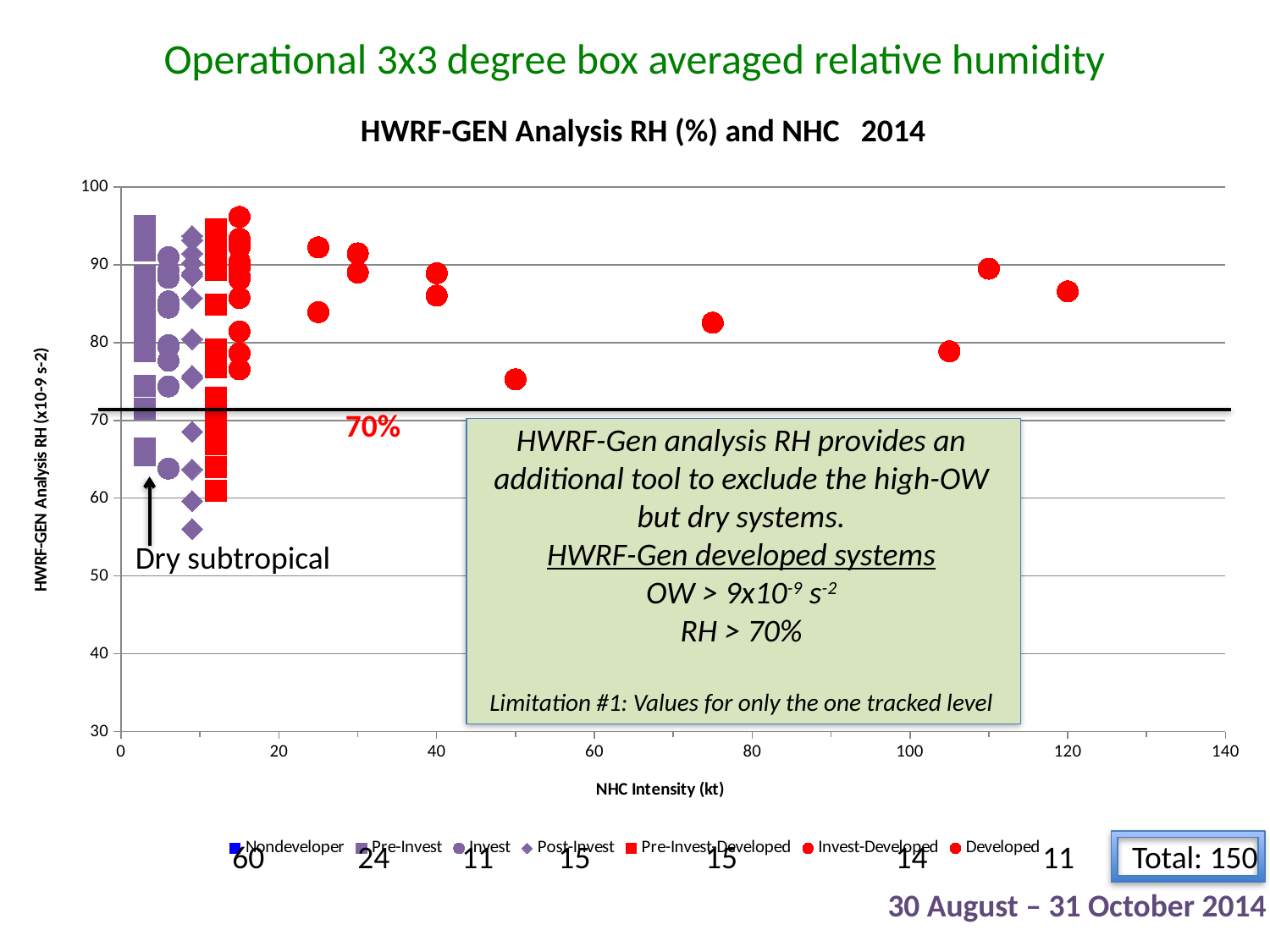
What is the label of the x axis? NHC Intensity (kt) Which has more cases, Pre-Invest or Post-Invest? Pre-Invest What is the title of the chart? HWRF-GEN Analysis RH (%) and NHC 2014 At what RH value is the horizontal reference line drawn on the chart? 70% Which series has the largest number of cases listed below the legend? Nondeveloper How many series does the chart legend list? 7 Is the RH value for the Developed point at about 50 kt greater or less than 80? less What kind of chart is shown on the slide? scatter chart What is the difference between the number of Nondeveloper cases and Pre-Invest cases? 36 Is the RH value for the Developed point at about 120 kt greater or less than 80? greater How many cases are listed for the Nondeveloper series below the legend? 60 What is the total number of cases shown on the slide? 150